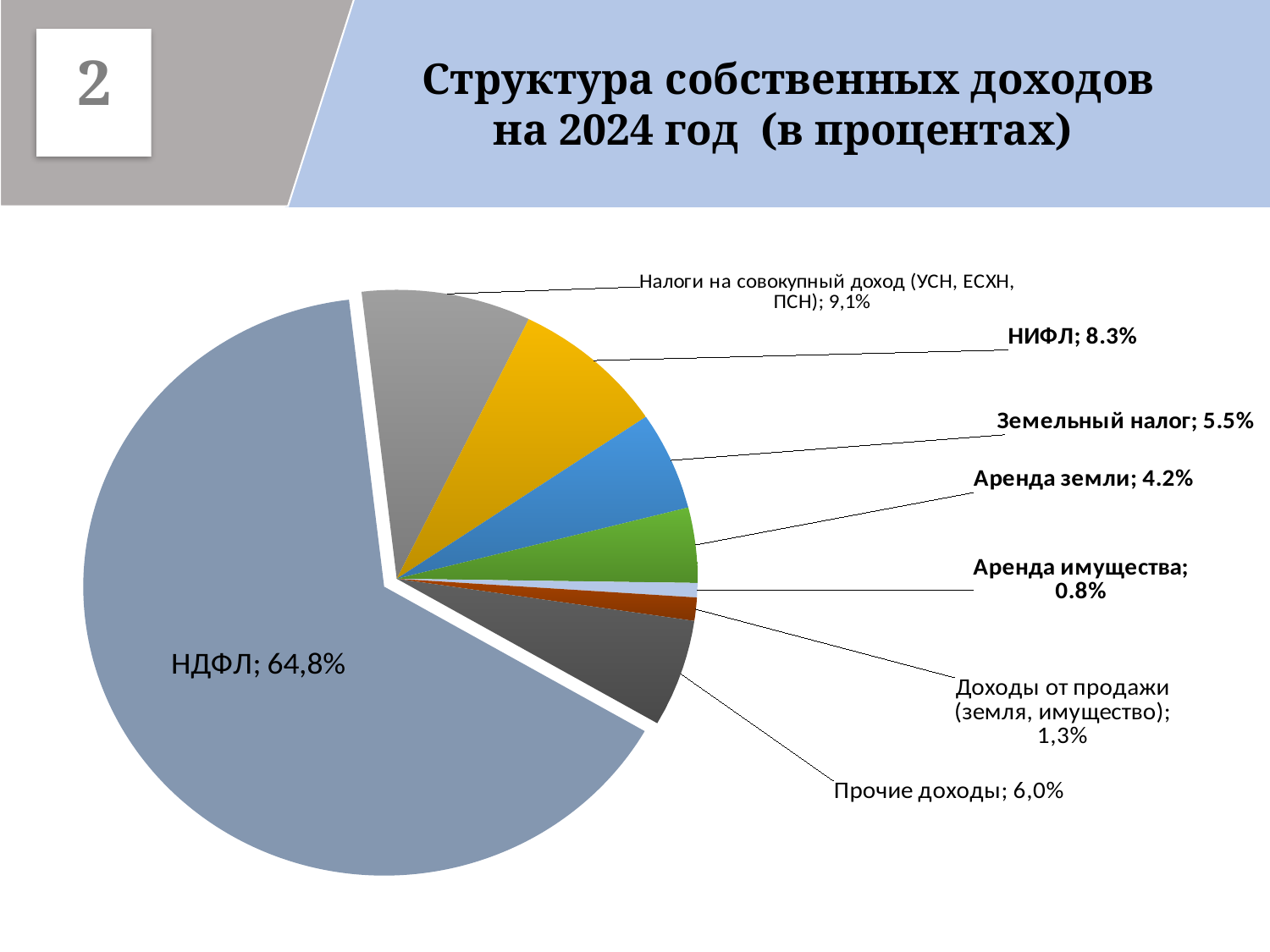
What is the value shown for Земельный налог? 5.5% Which is larger: Аренда земли or Доходы от продажи (земля, имущество)? Аренда земли What type of chart is shown on the slide? pie chart What is the value shown for Аренда имущества? 0.8% What is the title of the chart on the slide? Структура собственных доходов на 2024 год (в процентах) What is the value shown for Прочие доходы? 6,0% What is the share of НДФЛ in the pie chart? 64,8% Which category has the smallest slice of the pie? Аренда имущества Which category has the largest slice of the pie? НДФЛ What is the value shown for Налоги на совокупный доход (УСН, ЕСХН, ПСН)? 9,1% What is the value shown for НИФЛ? 8.3% How many slices does the pie chart have? 8